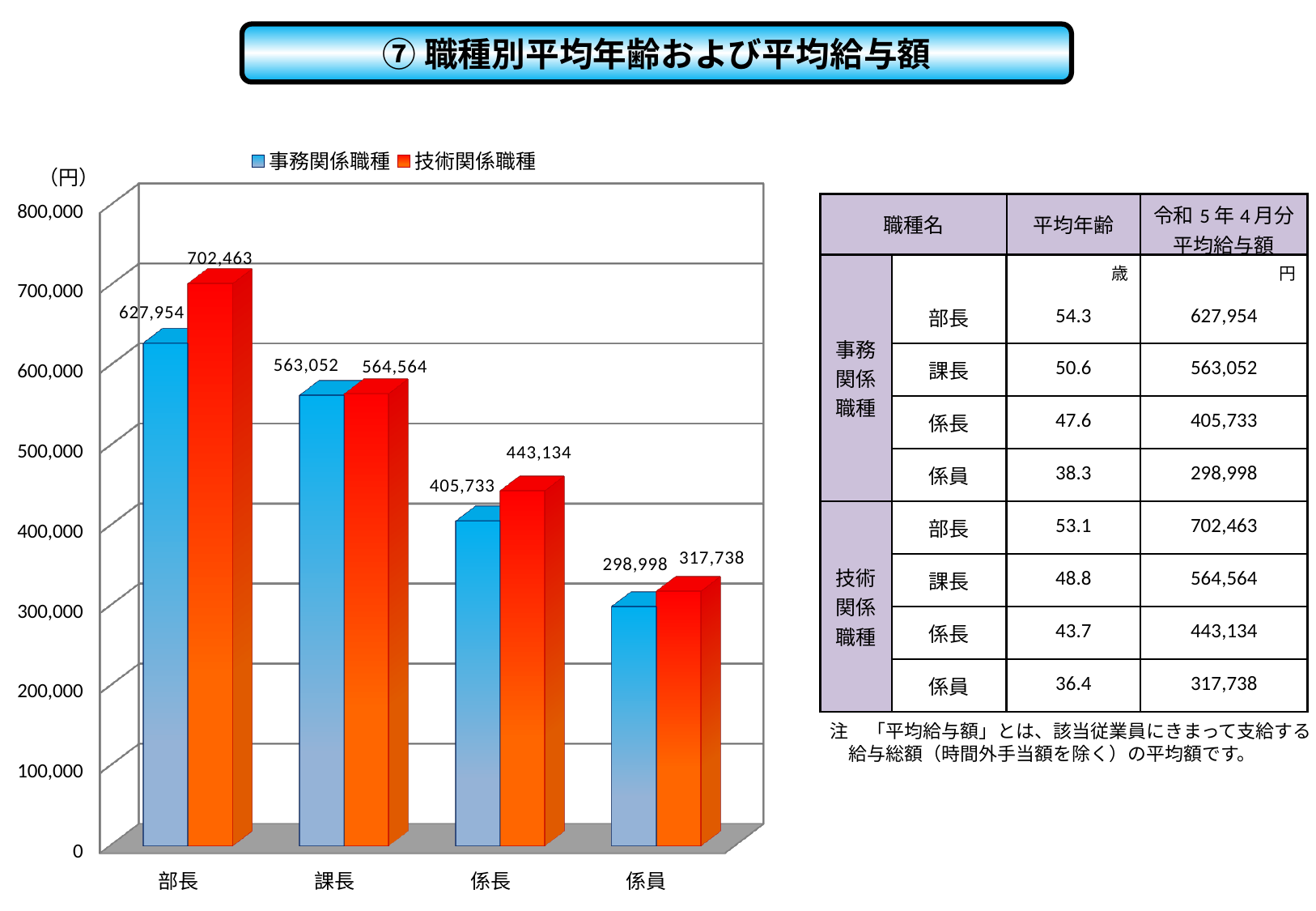
Which is larger for 係長: the 事務関係職種 value or the 技術関係職種 value? 技術関係職種 What is the value for 係員 in the 事務関係職種 series? 298,998 Which category has the lowest value in the 事務関係職種 series? 係員 What is the difference between the 技術関係職種 and 事務関係職種 values for 係員? 18,740 What is the value for 部長 in the 事務関係職種 series? 627,954 What is the value for 係長 in the 技術関係職種 series? 443,134 How many series does the legend list? 2 How many categories are shown on the x axis? 4 Is the value for 課長 in the 事務関係職種 series greater or less than 500,000? greater What kind of chart is shown on the slide? bar chart What is the difference between the 技術関係職種 and 事務関係職種 values for 部長? 74,509 Which category has the highest value in the 技術関係職種 series? 部長